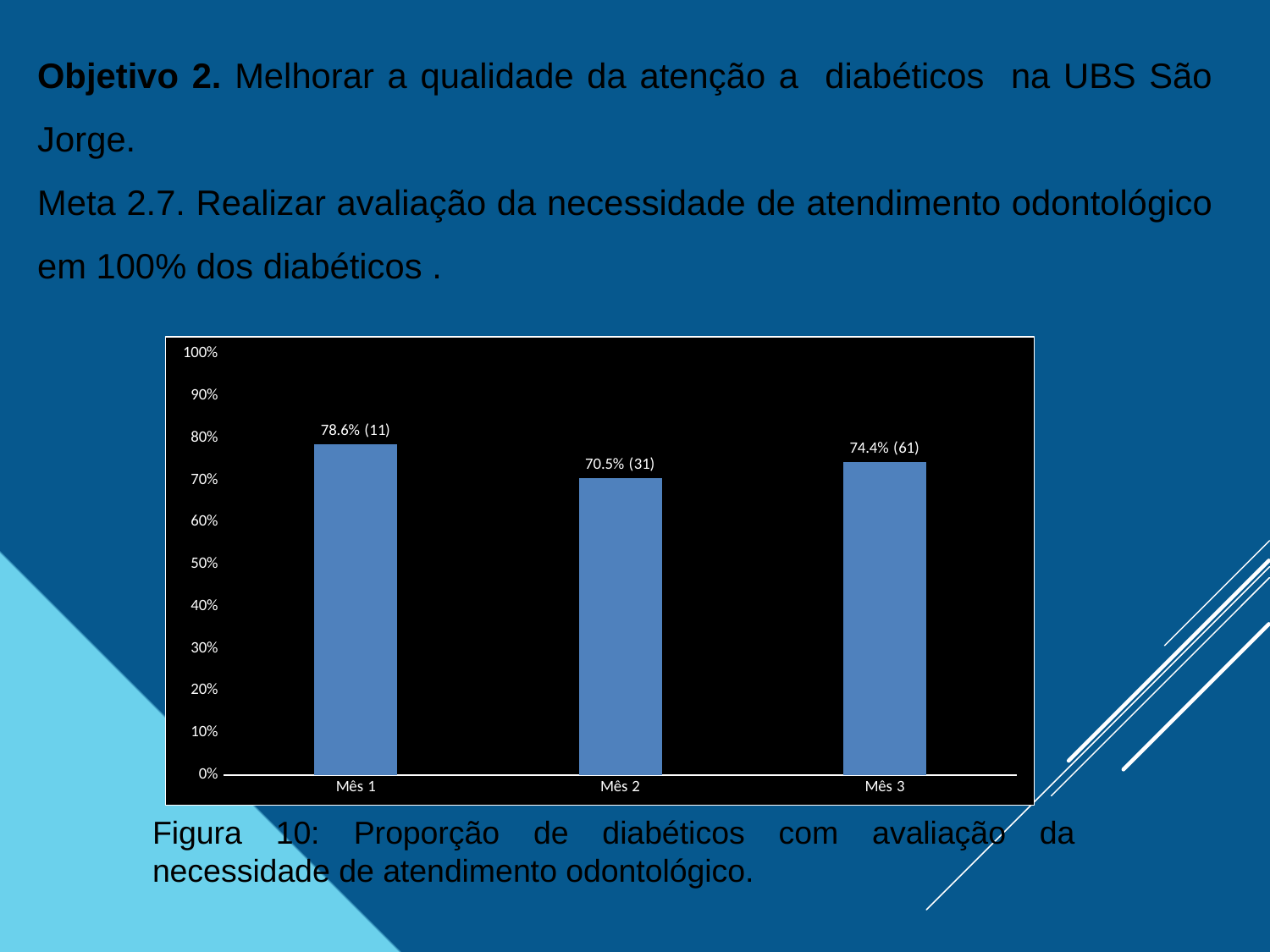
Which is larger, the value for Mês 1 or the value for Mês 3? Mês 1 Which month has the lowest proportion? Mês 2 Is the value for Mês 2 greater or less than 80%? less What is the difference in percentage points between Mês 1 and Mês 2? 8.1 Which month has the highest proportion? Mês 1 What is the value shown for Mês 3? 74.4% (61) What kind of chart is shown on the slide? bar chart How many months are shown on the x axis? 3 What is the difference in percentage points between Mês 3 and Mês 2? 3.9 What is the value shown for Mês 2? 70.5% (31) What is the figure number given in the caption below the chart? Figura 10 What is the value shown for Mês 1? 78.6% (11)